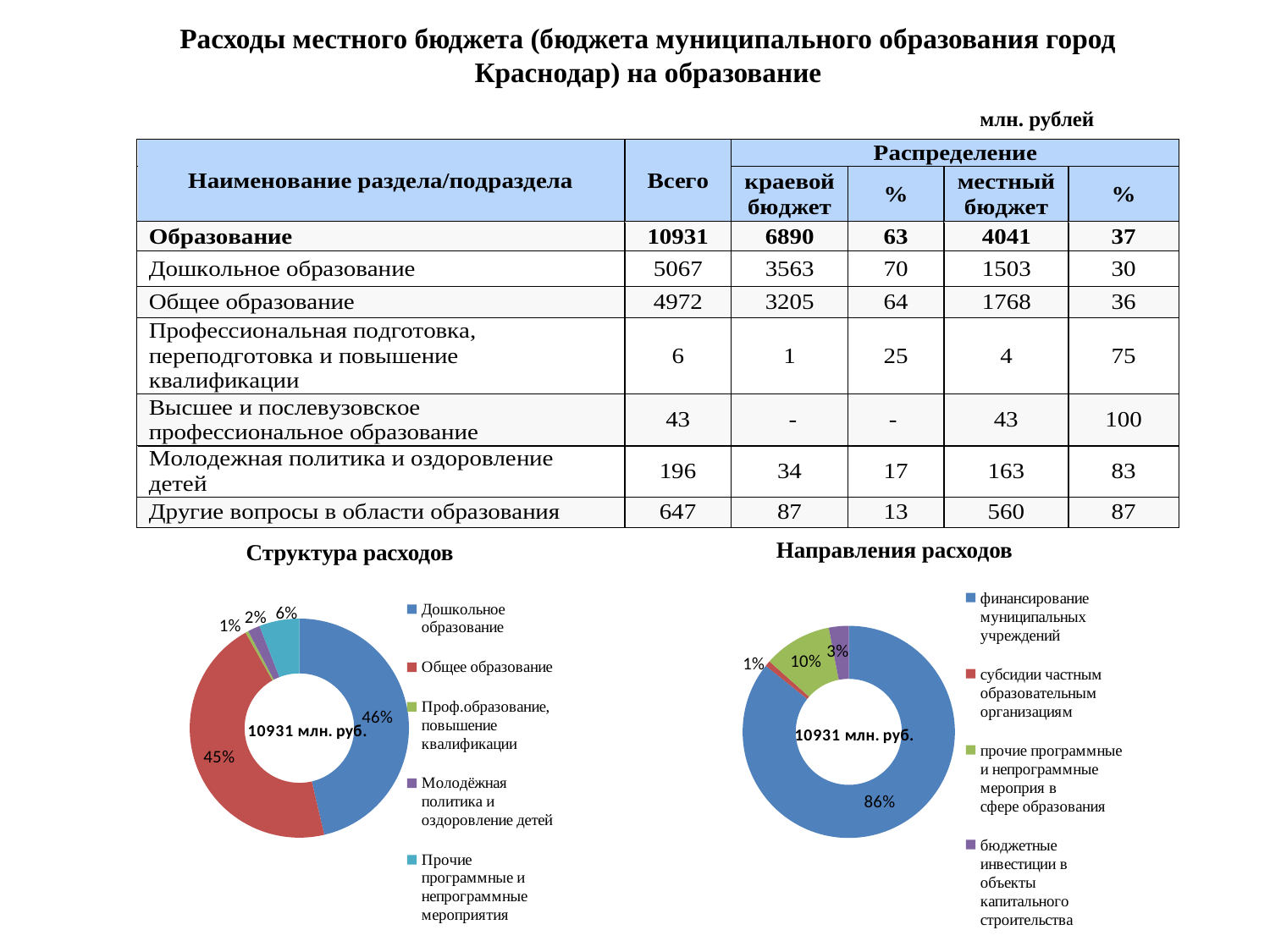
In the 'Структура расходов' chart, what share is shown for Общее образование? 45% In the 'Направления расходов' chart, which category has the largest share? финансирование муниципальных учреждений In the 'Структура расходов' chart, what total amount is printed in the centre of the doughnut? 10931 млн. руб. In the 'Направления расходов' chart, what share is shown for прочие программные и непрограммные мероприятия в сфере образования? 10% In the 'Структура расходов' chart, what share is shown for Дошкольное образование? 46% In the 'Структура расходов' chart, what share is shown for Прочие программные и непрограммные мероприятия? 6% In the 'Направления расходов' chart, what share is shown for финансирование муниципальных учреждений? 86% In the 'Структура расходов' chart, which category has the smallest share? Проф.образование, повышение квалификации What type of chart is 'Направления расходов'? Doughnut chart In the 'Направления расходов' chart, what share is shown for бюджетные инвестиции в объекты капитального строительства? 3% In the 'Структура расходов' chart, how many categories does the legend list? 5 In the 'Направления расходов' chart, what is the difference in percentage points between финансирование муниципальных учреждений and прочие программные и непрограммные мероприятия? 76